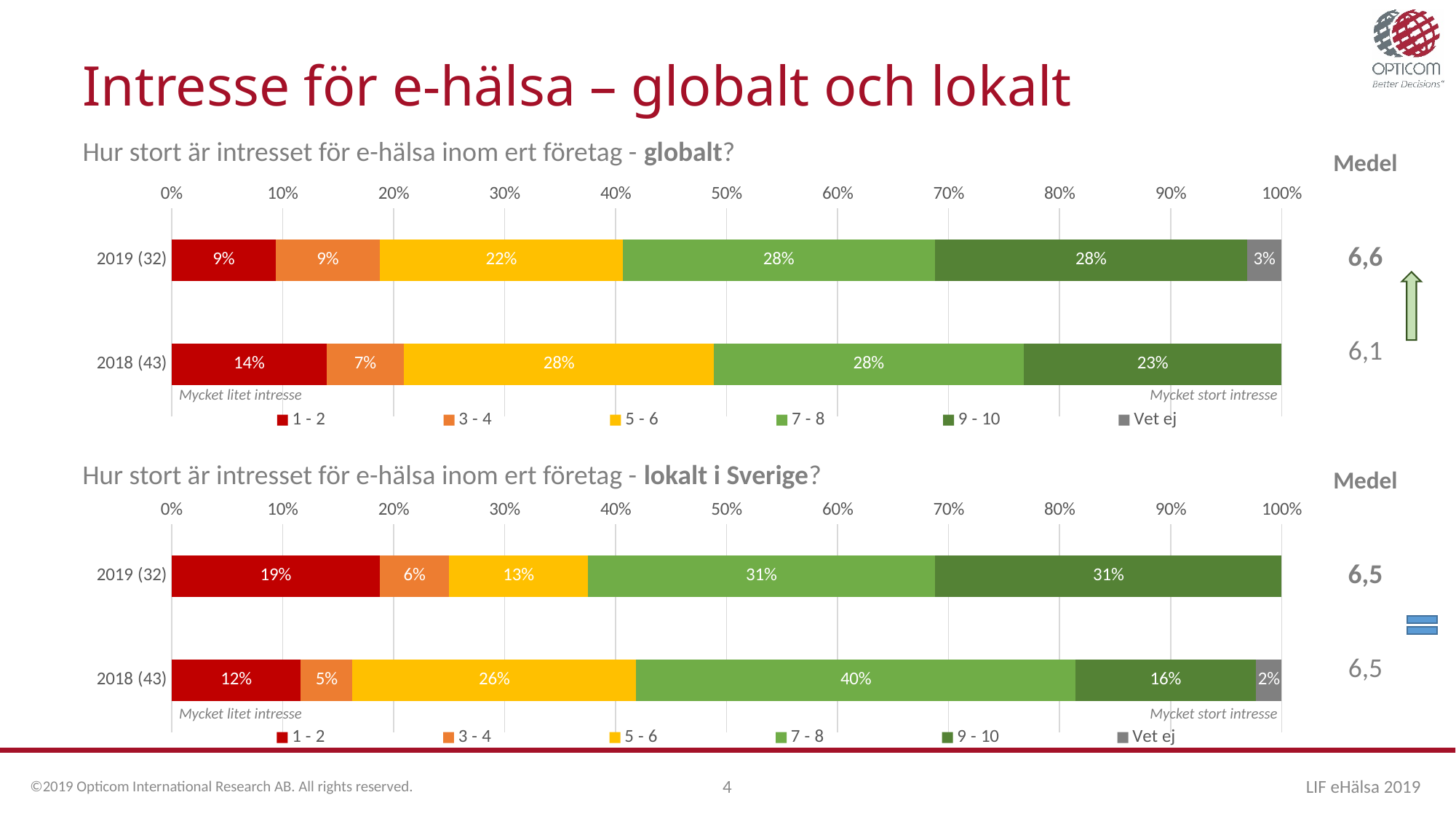
In the bottom chart (lokalt i Sverige), which year has the larger 1 - 2 share, 2019 (32) or 2018 (43)? 2019 (32) What is the Medel (mean) value shown for 2019 (32) in the top chart (globalt)? 6,6 In the top chart (globalt), what is the difference between the 5 - 6 share for 2018 (43) and for 2019 (32)? 6 percentage points In the top chart (globalt), which response category has the smallest share for 2019 (32)? Vet ej In the top chart (globalt), what percentage of 2019 (32) respondents answered 9 - 10? 28% In the top chart (globalt), what percentage of 2018 (43) respondents answered 1 - 2? 14% How many series does the legend of the top chart (globalt) list? 6 In the bottom chart (lokalt i Sverige), which response category has the largest share for 2018 (43)? 7 - 8 How many year categories are shown in the top chart (globalt)? 2 What kind of chart is the bottom chart (lokalt i Sverige)? Stacked bar chart In the bottom chart (lokalt i Sverige), what percentage of 2019 (32) respondents answered 5 - 6? 13% In the bottom chart (lokalt i Sverige), what percentage of 2018 (43) respondents answered 7 - 8? 40%